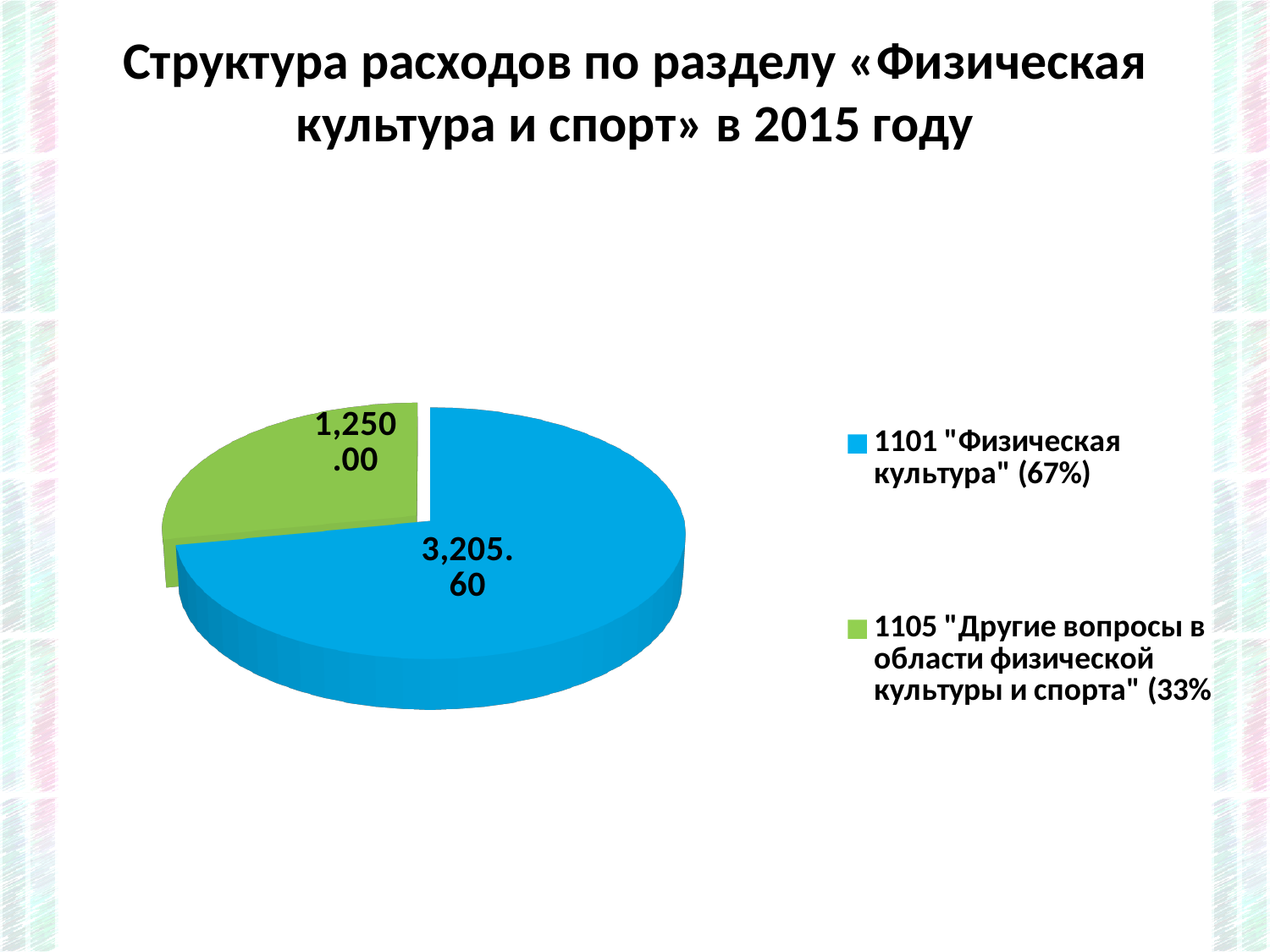
What is the value for 1101 "Физическая культура"? 3,205.60 What is the difference between the value for 1101 "Физическая культура" and the value for 1105 "Другие вопросы в области физической культуры и спорта"? 1,955.60 What is the total of the two values shown in the pie chart? 4,455.60 What type of chart is shown on the slide? pie chart Which is larger: the value for 1101 "Физическая культура" or the value for 1105 "Другие вопросы в области физической культуры и спорта"? 1101 "Физическая культура" What is the value for 1105 "Другие вопросы в области физической культуры и спорта"? 1,250.00 Which category has the smallest slice of the pie? 1105 "Другие вопросы в области физической культуры и спорта" What share of the pie does 1105 "Другие вопросы в области физической культуры и спорта" represent? 33% What share of the pie does 1101 "Физическая культура" represent? 67% Which category has the largest slice of the pie? 1101 "Физическая культура" What colour is the slice for 1105 "Другие вопросы в области физической культуры и спорта"? green How many slices does the pie chart have? 2